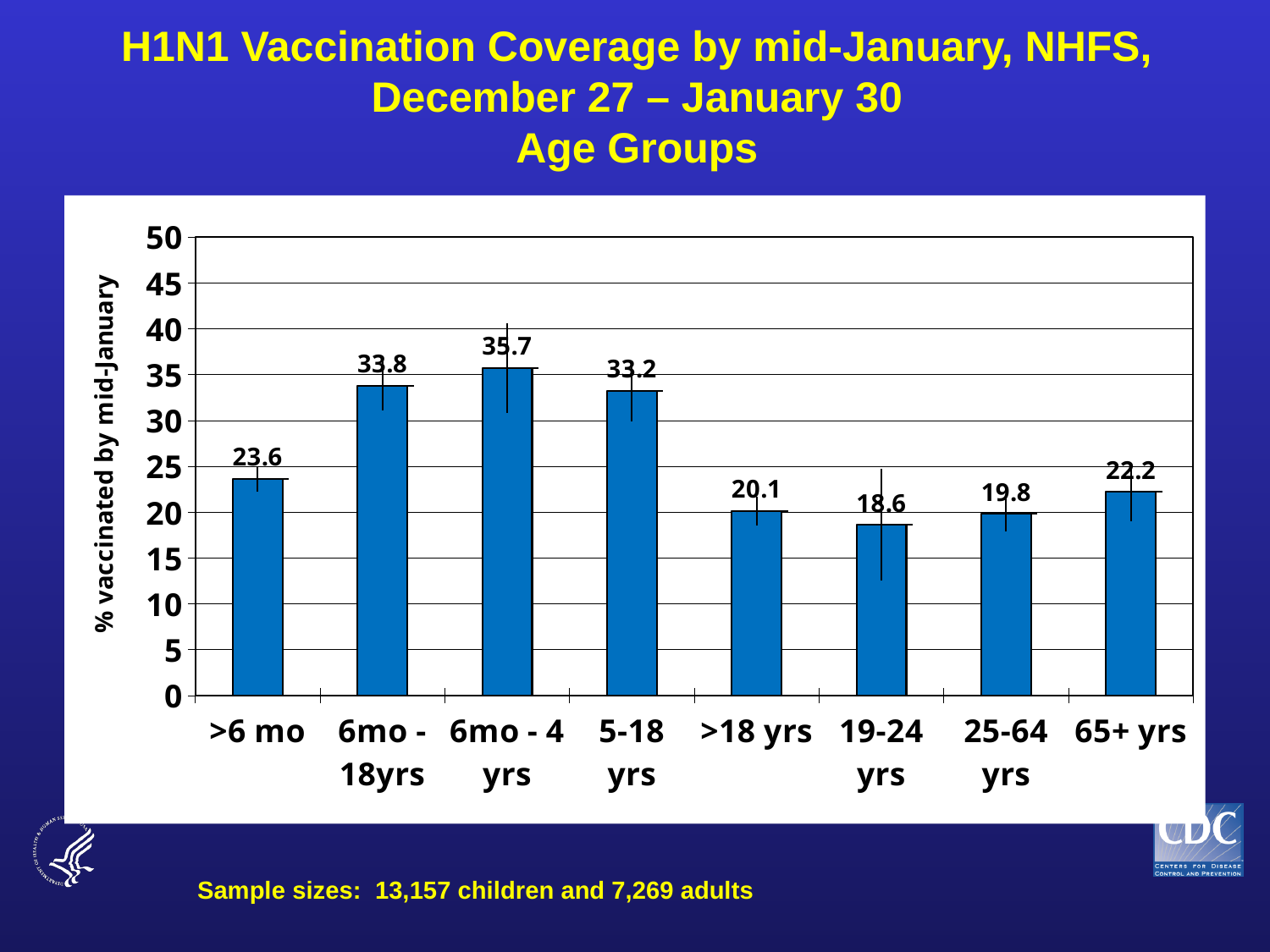
Which age group has the highest % vaccinated by mid-January? 6mo - 4 yrs What kind of chart is shown on the slide? bar chart What is the label of the y axis? % vaccinated by mid-January What is the maximum value shown on the y axis? 50 What is the % vaccinated by mid-January for the 65+ yrs age group? 22.2 Which age group has the lowest % vaccinated by mid-January? 19-24 yrs Which has a higher % vaccinated by mid-January: >6 mo or 25-64 yrs? >6 mo What is the % vaccinated by mid-January for the 6mo - 4 yrs age group? 35.7 What is the difference in % vaccinated between the 6mo - 18yrs group and the >18 yrs group? 13.7 How many age groups are shown on the chart? 8 Is the value for the 5-18 yrs group greater or less than 30? greater What is the % vaccinated by mid-January for the 19-24 yrs age group? 18.6